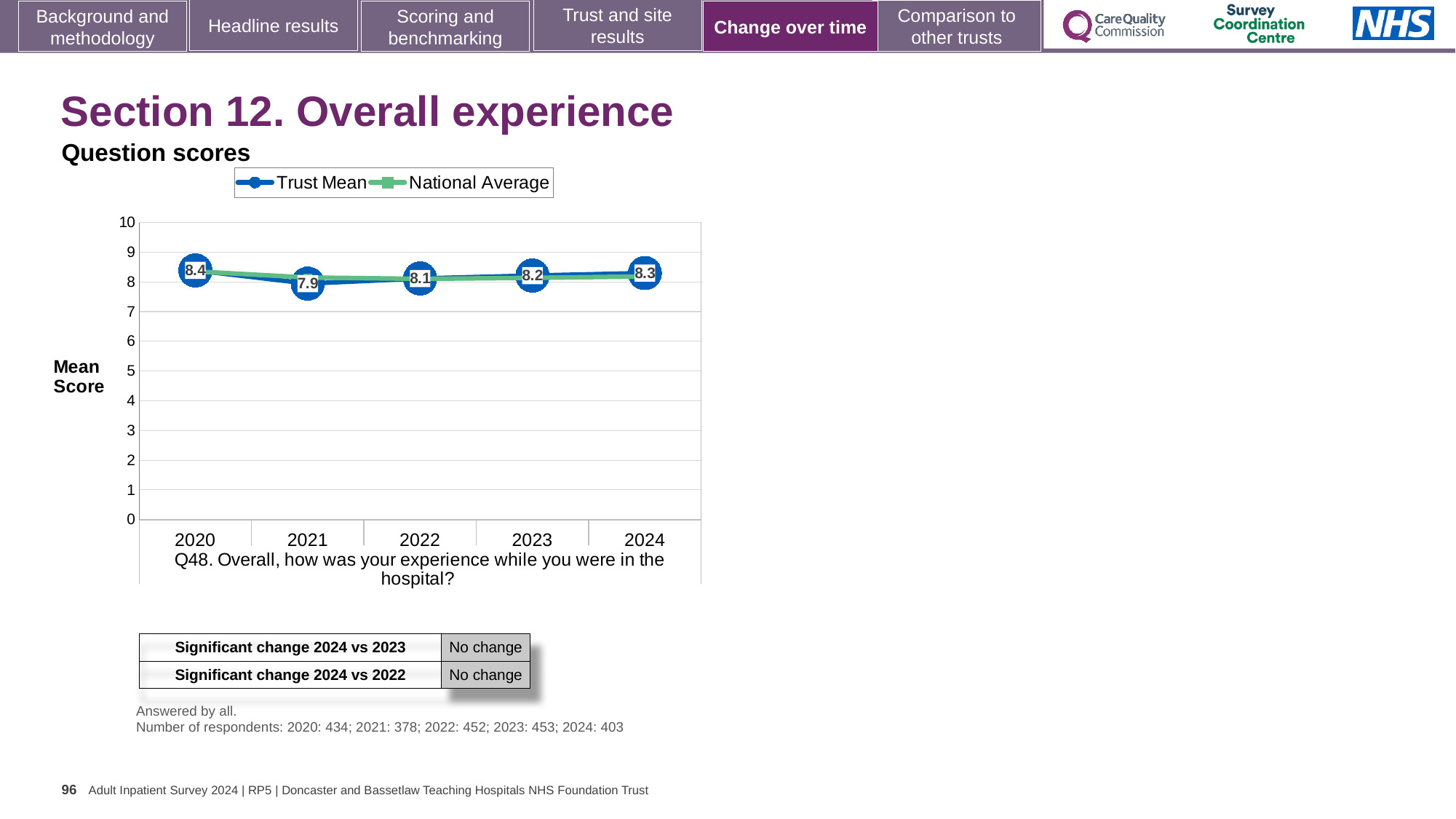
What is the difference between the Trust Mean scores for 2020 and 2021? 0.5 What is the Trust Mean score for 2021? 7.9 What is the Trust Mean score for 2024? 8.3 How many series does the legend list? 2 Does the Trust Mean score rise or fall from 2021 to 2024? Rise Which year has the larger Trust Mean score, 2022 or 2024? 2024 What kind of chart is shown on the slide? Line chart Is the National Average value for 2020 greater or less than 7? greater In which year is the Trust Mean score lowest? 2021 In which year is the Trust Mean score highest? 2020 What is the Trust Mean score for 2020? 8.4 How many years are plotted on the x axis? 5